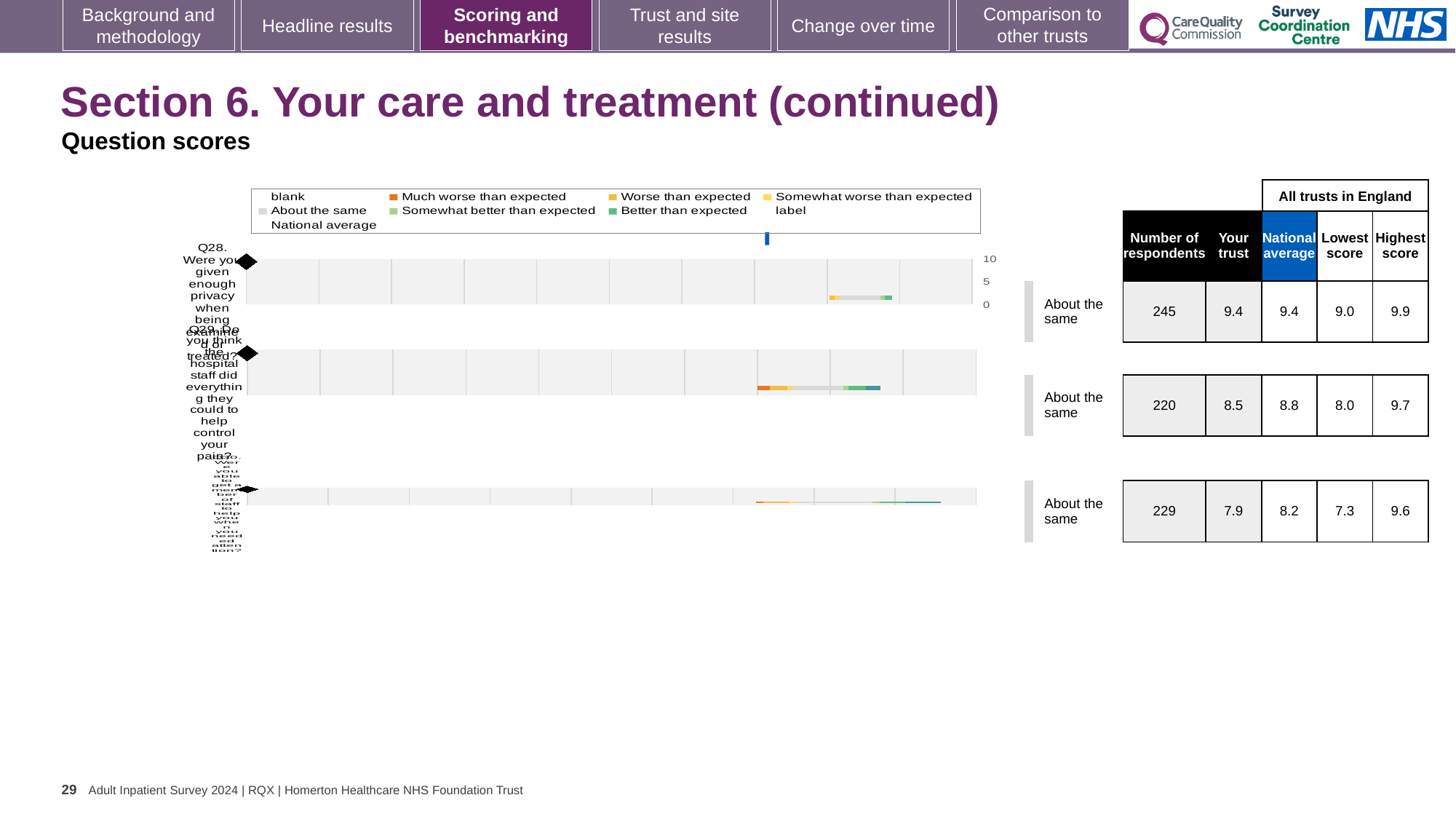
What colour does the legend use for 'Much worse than expected'? Orange How many survey questions are plotted in the chart? 3 What is the highest score among all trusts in England for Q28? 9.9 What kind of chart is used to show the question scores? bar chart For Q29, what is the difference between the highest score and the lowest score among all trusts in England? 1.7 What is the national average for Q29? 8.8 What is the 'Your trust' score for Q28? 9.4 Which question has the highest 'Your trust' score? Q28 How many respondents are listed for Q30? 229 Which question has the lowest 'Lowest score' among all trusts in England? Q30 For Q30, which is larger: the 'Your trust' score or the national average? National average What benchmark category is shown for Q29? About the same